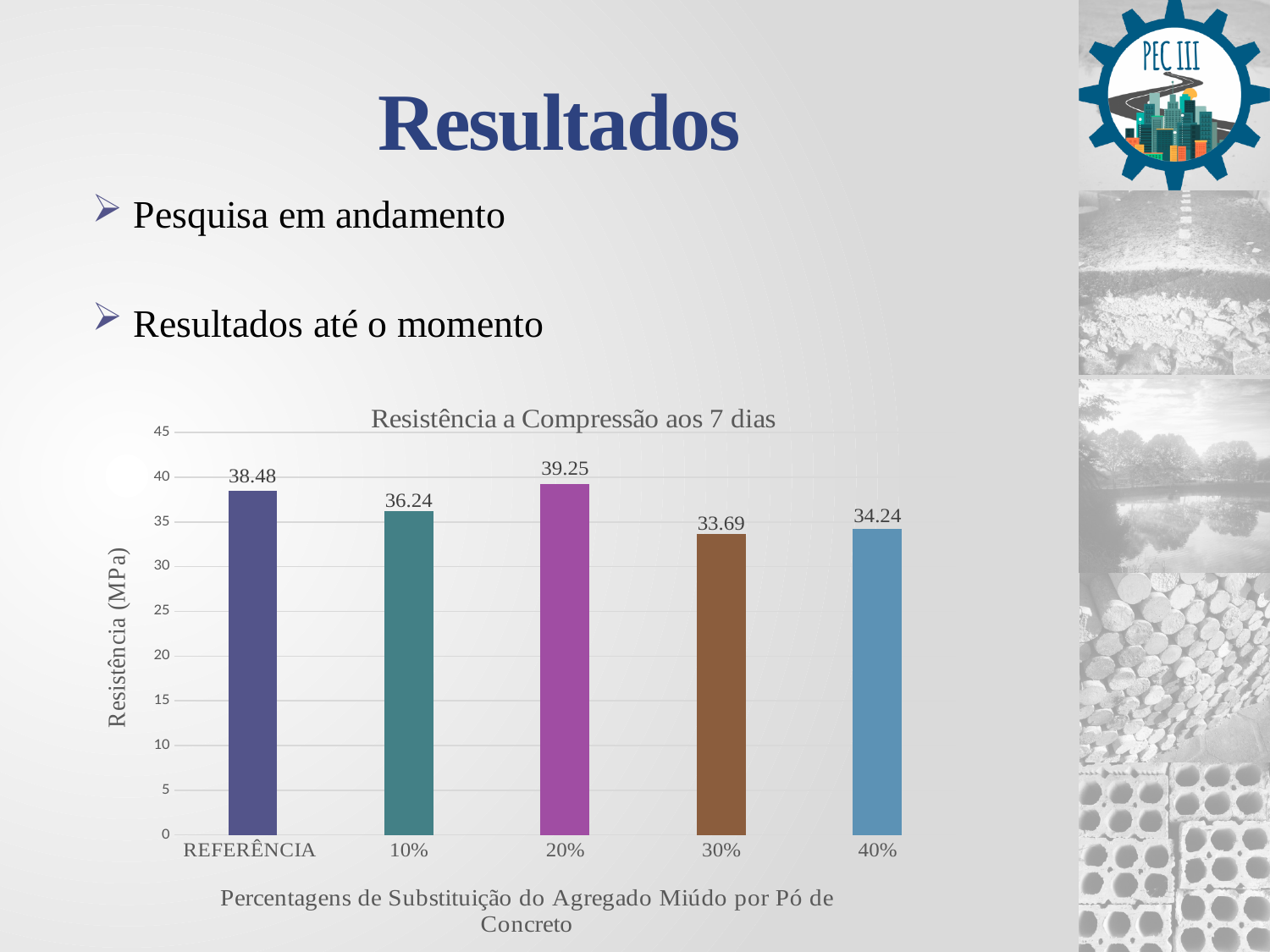
Is the value for 40% greater or less than 35? less What is the label of the y axis? Resistência (MPa) What is the title of the chart? Resistência a Compressão aos 7 dias Which category has the lowest value? 30% Which is larger, the value for 10% or the value for 40%? 10% Which category has the highest value? 20% What is the value for 30%? 33.69 What is the difference between the values for REFERÊNCIA and 10%? 2.24 What is the value for 20%? 39.25 What is the value for REFERÊNCIA? 38.48 How many categories are shown on the x axis? 5 What kind of chart is shown? bar chart